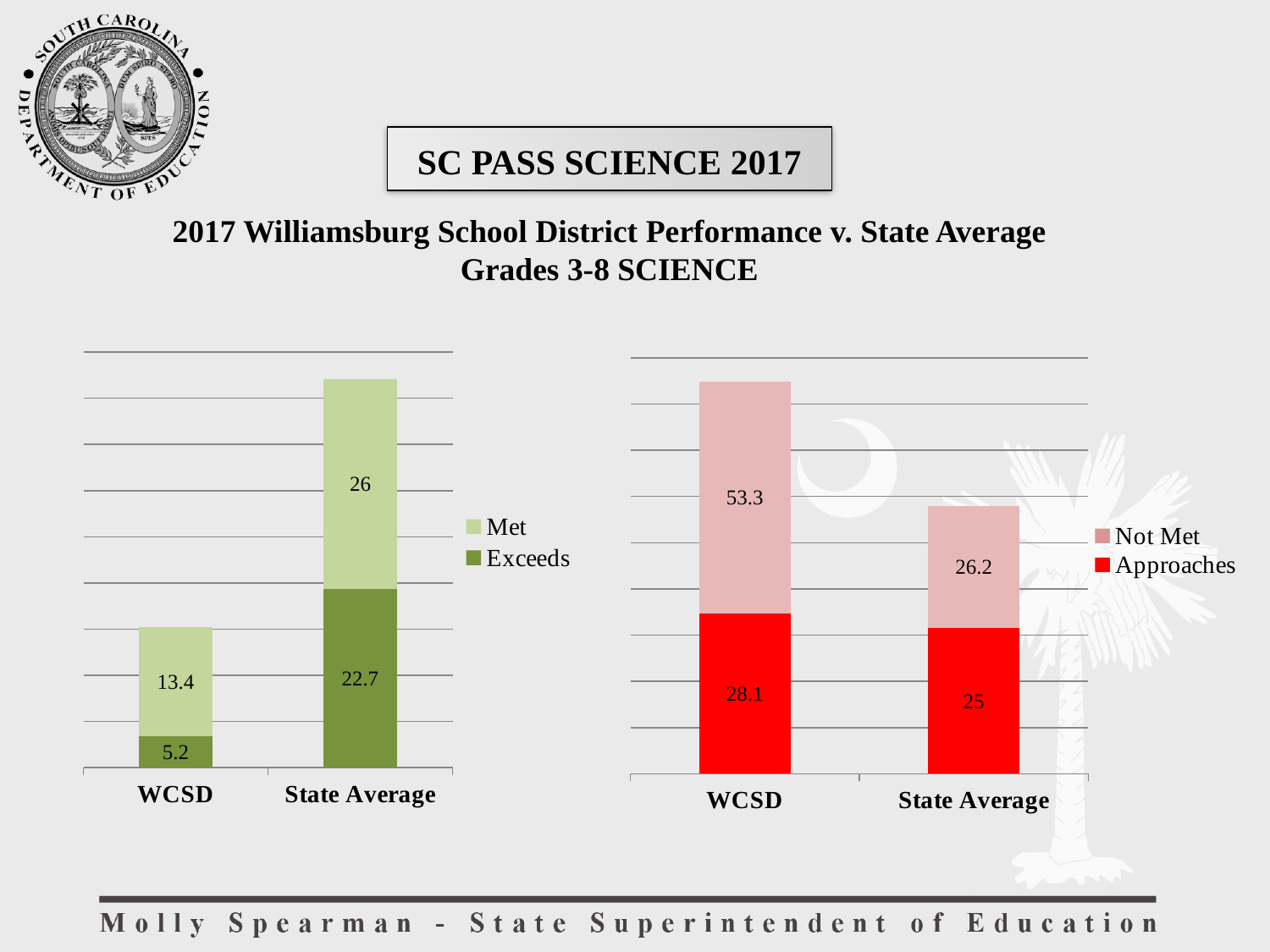
What kind of chart is the left chart (Met/Exceeds)? Stacked bar chart How many series does the legend of the right chart (Not Met/Approaches) list? 2 In the left chart (Met/Exceeds), what is the Exceeds value for State Average? 22.7 In the left chart (Met/Exceeds), what is the total of the stacked bar for State Average? 48.7 In the right chart (Not Met/Approaches), what is the Approaches value for State Average? 25 In the left chart (Met/Exceeds), what is the difference between the Met values for State Average and WCSD? 12.6 In the right chart (Not Met/Approaches), what is the difference between the Not Met values for WCSD and State Average? 27.1 In the left chart (Met/Exceeds), what is the Met value for WCSD? 13.4 In the right chart (Not Met/Approaches), what is the Not Met value for WCSD? 53.3 In the right chart (Not Met/Approaches), what is the total of the stacked bar for WCSD? 81.4 In the right chart (Not Met/Approaches), which category has the higher Not Met value? WCSD In the left chart (Met/Exceeds), which category has the higher Exceeds value, WCSD or State Average? State Average